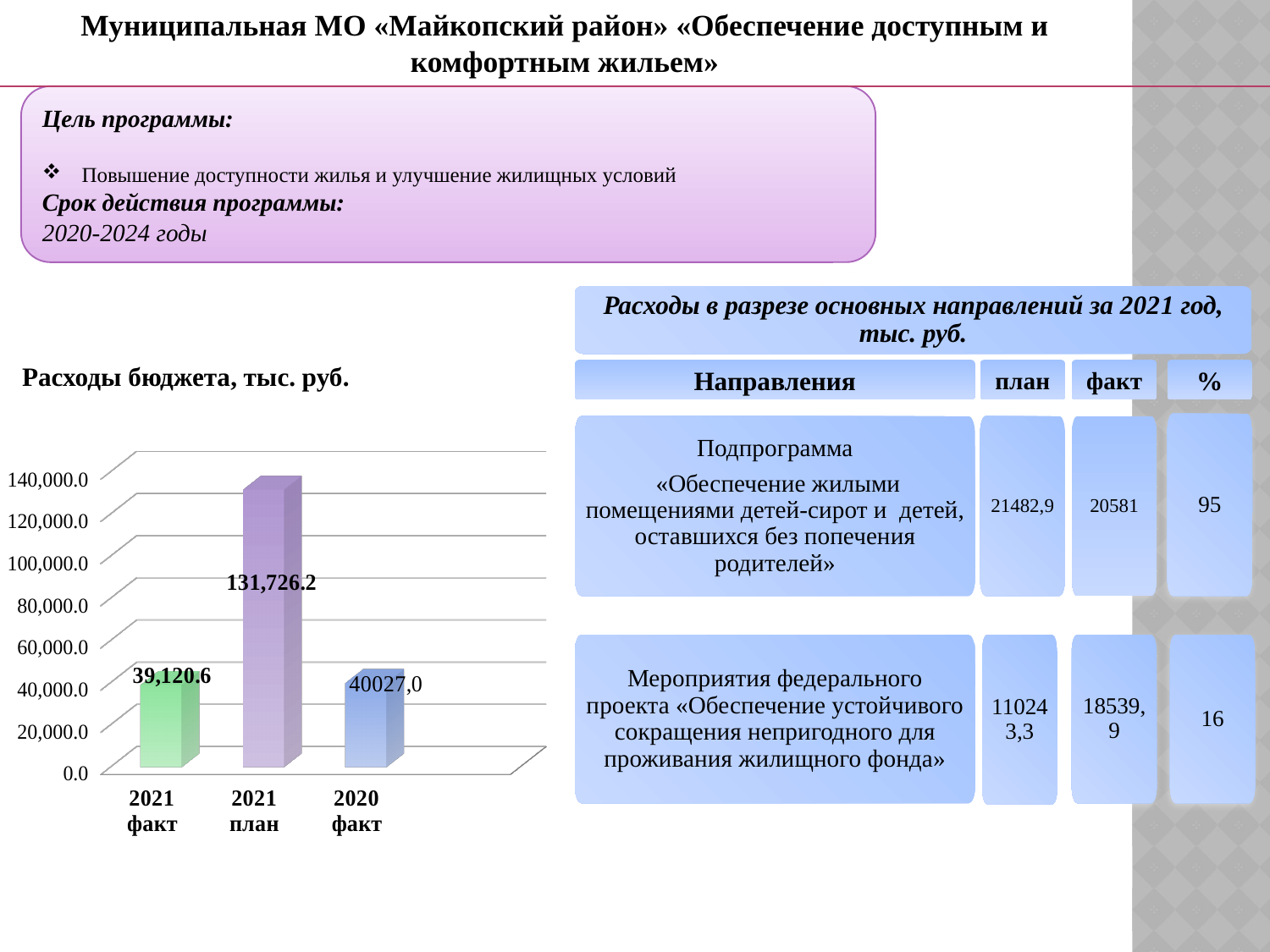
How many categories are shown in the bar chart? 3 What is the value for 2021 факт in the bar chart? 39,120.6 What is the value for 2020 факт in the bar chart? 40027,0 Which is larger, the value for 2020 факт or the value for 2021 факт? 2020 факт Which category has the lowest value in the bar chart? 2021 факт What kind of chart is shown on the slide? bar chart Is the value for 2021 факт greater or less than 60,000.0? less Is the value for 2021 план greater or less than 120,000.0? greater Which category has the highest value in the bar chart? 2021 план What is the value for 2021 план in the bar chart? 131,726.2 What is the title of the chart on the slide? Расходы бюджета, тыс. руб. What is the difference between the values for 2021 план and 2021 факт? 92,605.6